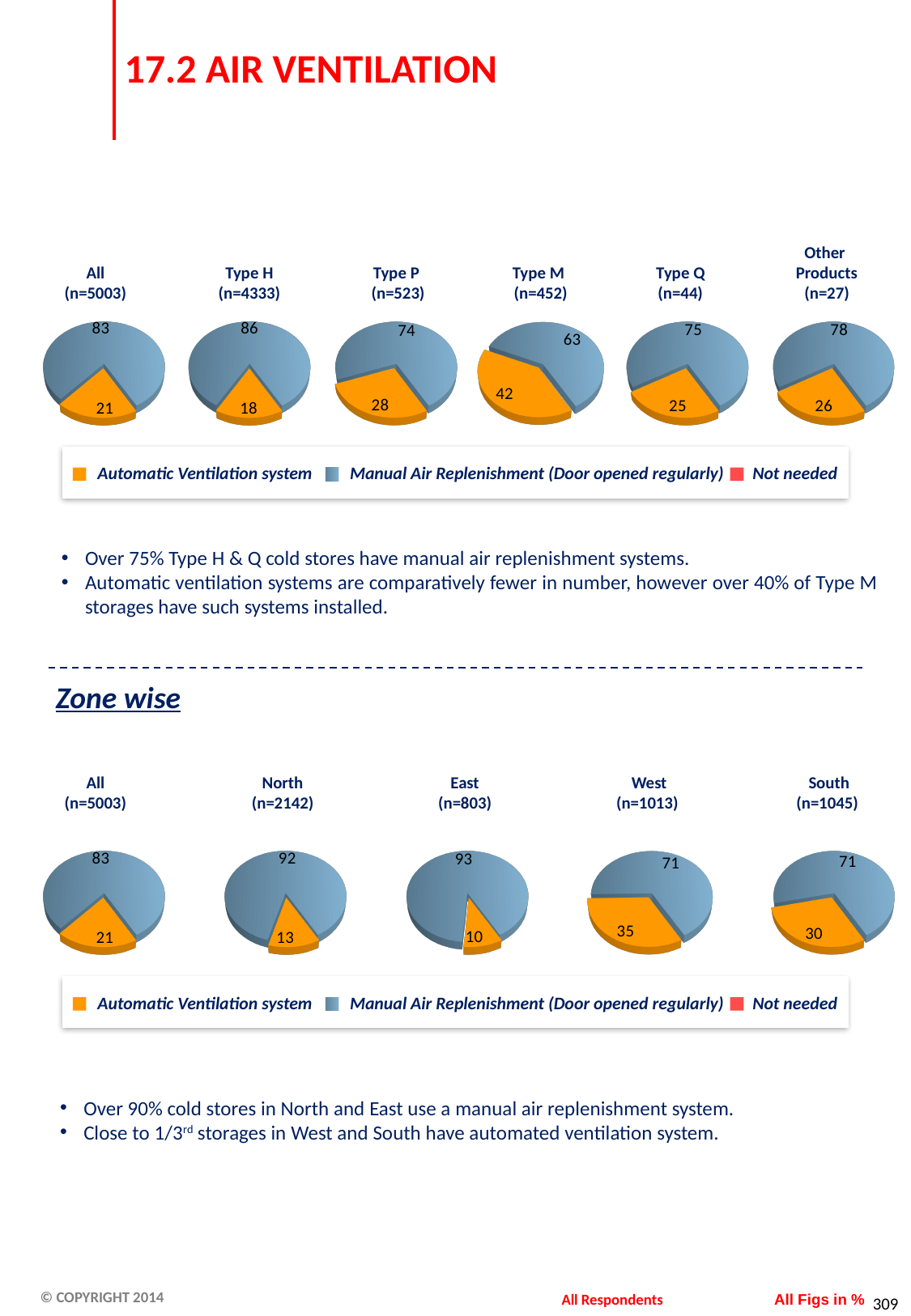
In the top row of pie charts, what share of the Type H (n=4333) pie is Automatic Ventilation system? 18 What is the sample size shown for the Type H pie chart in the top row? n=4333 What kind of chart is used to show the air ventilation data on this slide? Pie chart How many entries does the legend below the top row of pie charts list? 3 In the Zone wise pie charts, what is the difference between the Automatic Ventilation system values for West and South? 5 In the Zone wise pie charts, what is the value for Manual Air Replenishment (Door opened regularly) in the North (n=2142) pie? 92 Among the Zone wise pie charts, which zone has the lowest value for Automatic Ventilation system? East Among the top row of pie charts, which category has the highest value for Automatic Ventilation system? Type M In the top row of pie charts, what is the value for Automatic Ventilation system in the Type M (n=452) pie? 42 In the top row of pie charts, what is the value for Manual Air Replenishment (Door opened regularly) in the Other Products (n=27) pie? 78 In the top row of pie charts, which has the larger Automatic Ventilation system value, Type P or Type Q? Type P How many pie charts are shown in the Zone wise section? 5